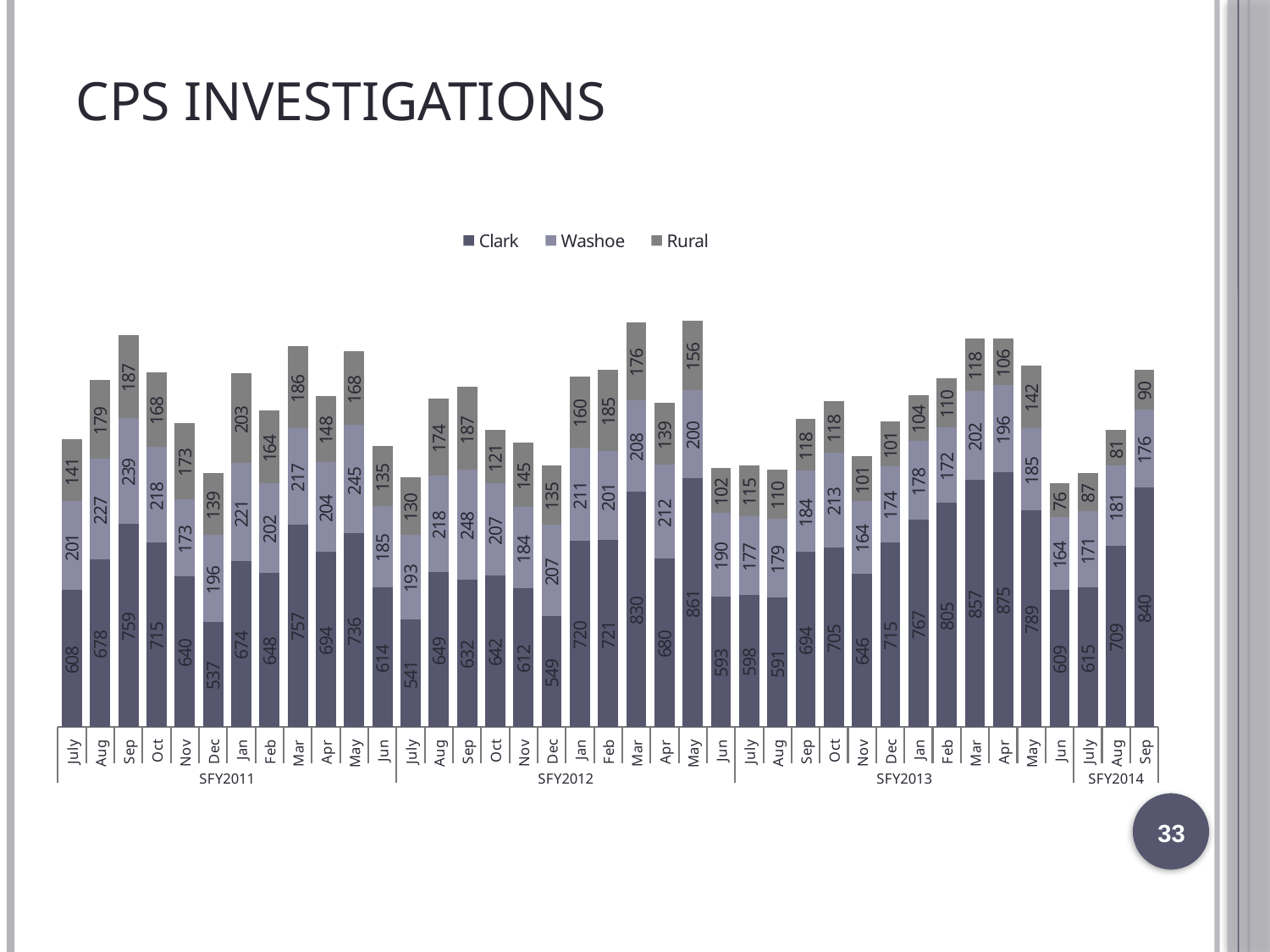
What is the difference between the Clark values for Sep SFY2014 and July SFY2014? 225 What type of chart is shown on the slide? Stacked bar chart How many months are shown for SFY2014? 3 What is the Rural value for Jun in SFY2013? 76 Which month has the lowest Clark value across the whole chart? Dec SFY2011 What is the title of the slide? CPS Investigations How many series does the legend list? 3 What is the Washoe value for Sep in SFY2012? 248 Which month has the highest Clark value across the whole chart? Apr SFY2013 Which is larger, the Rural value for Jan SFY2011 or the Rural value for Jan SFY2013? Jan SFY2011 What is the total of the stacked bar for May SFY2012? 1217 What is the Clark value for May in SFY2012? 861